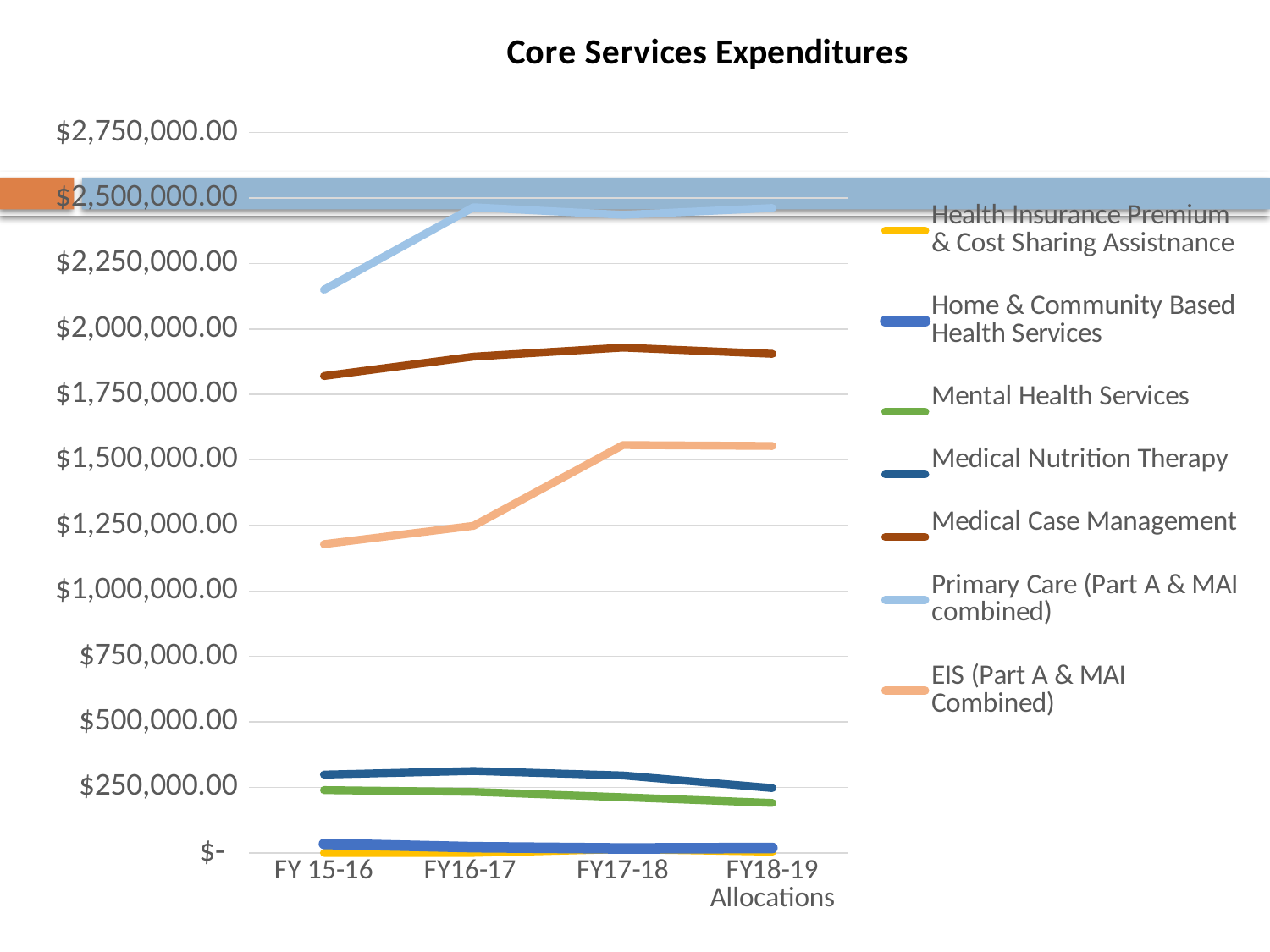
Is the value for Primary Care (Part A & MAI combined) in FY 15-16 greater or less than $2,250,000.00? less Does the EIS (Part A & MAI Combined) line rise or fall from FY 15-16 to FY18-19 Allocations? rise How many fiscal-year categories are shown on the x axis? 4 How many series does the legend list? 7 Is the value for EIS (Part A & MAI Combined) in FY 15-16 greater or less than $1,250,000.00? less Is the value for EIS (Part A & MAI Combined) in FY17-18 greater or less than $1,500,000.00? greater Does the Mental Health Services line rise or fall from FY 15-16 to FY18-19 Allocations? fall In FY 15-16, which is larger: Medical Nutrition Therapy or Mental Health Services? Medical Nutrition Therapy What is the title of the chart? Core Services Expenditures What kind of chart is shown on the slide? line chart Which series has the highest value in FY 15-16? Primary Care (Part A & MAI combined)